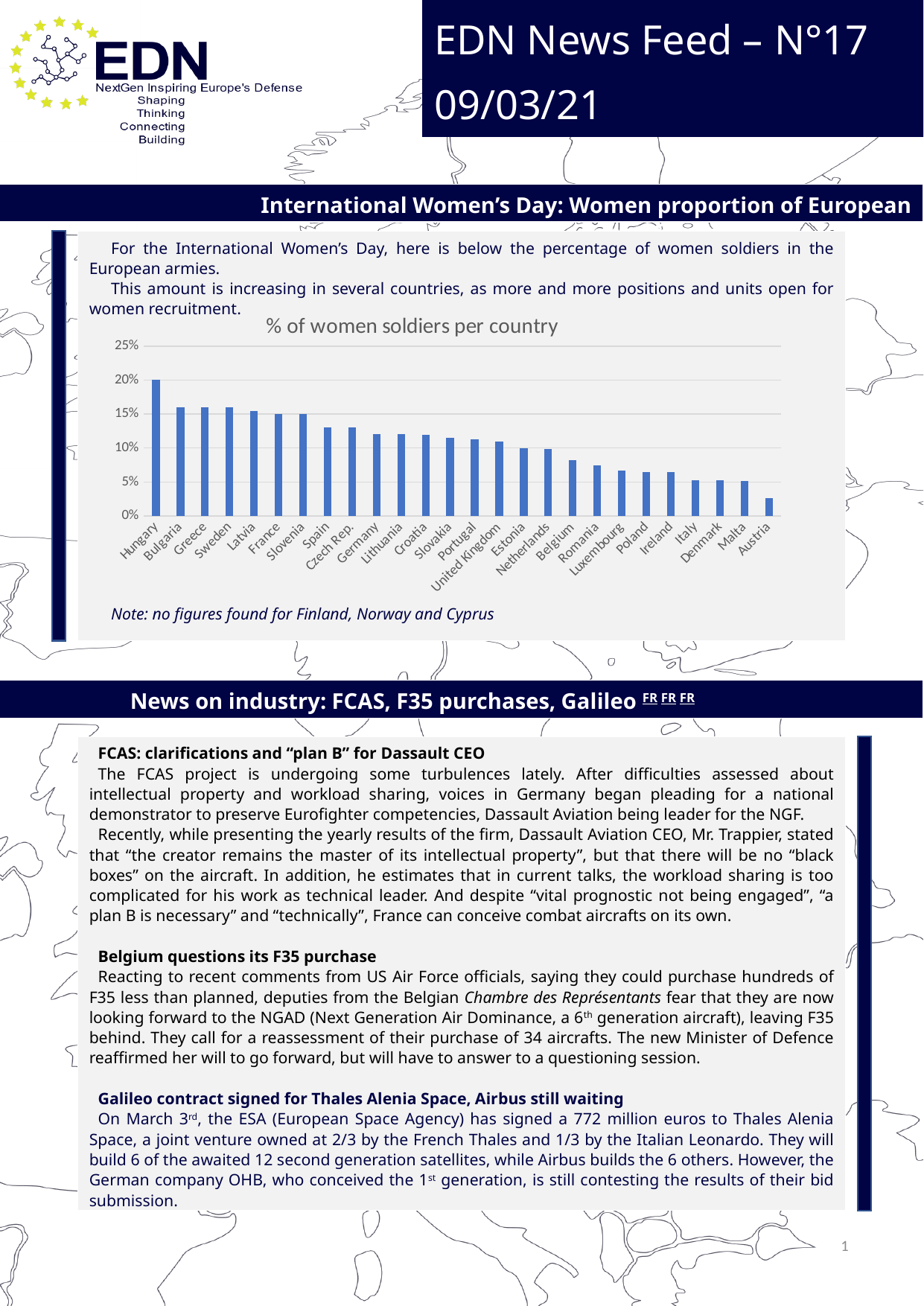
Is the value for Austria greater or less than 5%? less Which has a higher percentage of women soldiers, Greece or Poland? Greece Is the value for Hungary greater or less than 15%? greater Is the value for Spain greater or less than 10%? greater Which country has the lowest percentage of women soldiers in the chart? Austria Do the values rise or fall from left to right along the x axis? fall What is the title of the chart? % of women soldiers per country What kind of chart is shown on the slide? bar chart Which country has the highest percentage of women soldiers in the chart? Hungary How many countries are shown in the chart? 26 According to the note under the chart, for which countries were no figures found? Finland, Norway and Cyprus